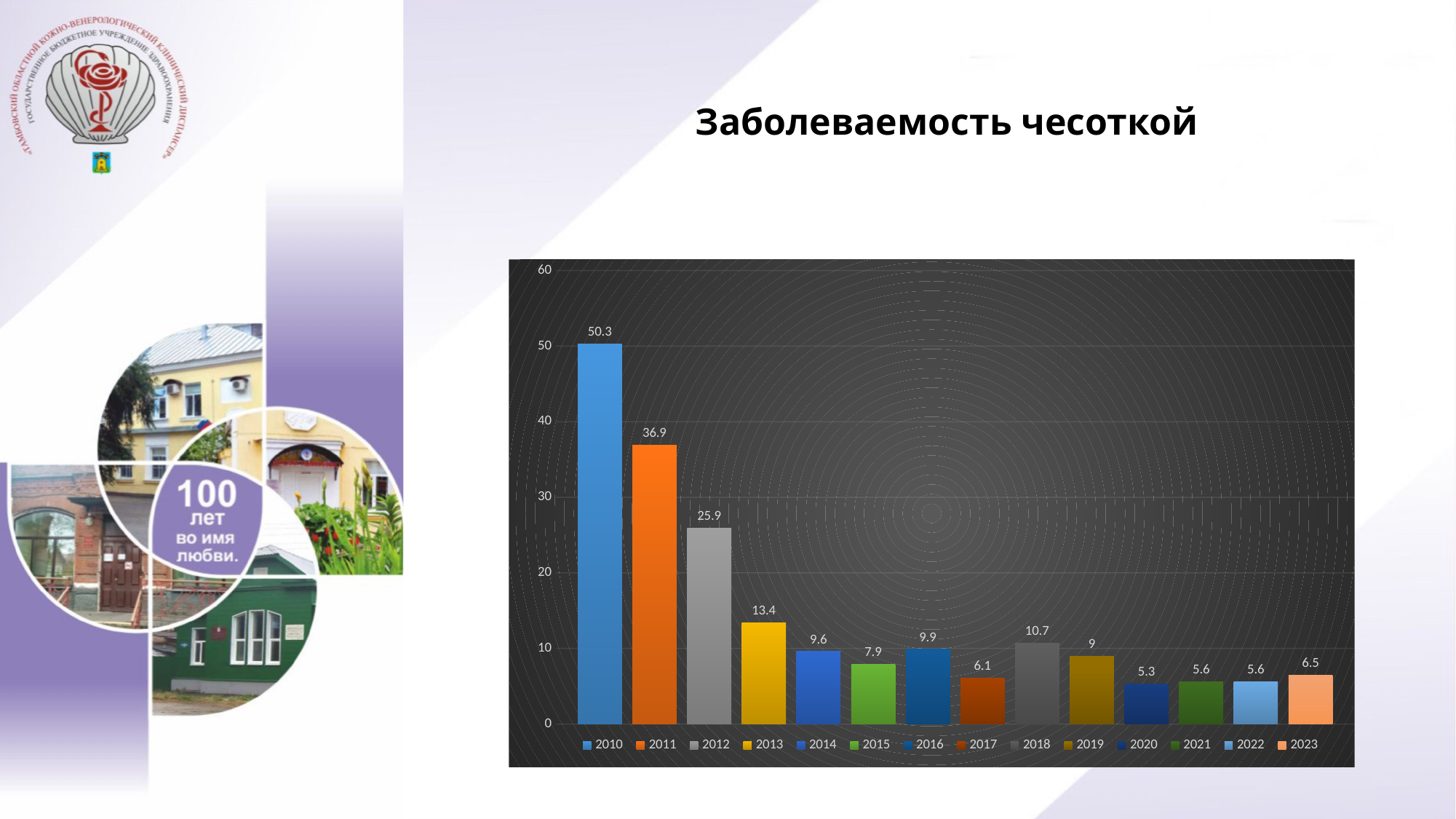
Which is larger, the value for 2016 or the value for 2017? 2016 What is the value shown for 2018? 10.7 How many years are plotted in the chart? 14 What is the difference between the values for 2013 and 2014? 3.8 What is the value shown for 2010? 50.3 Which year has the highest value? 2010 What is the value shown for 2023? 6.5 What kind of chart is shown on the slide? Bar chart What is the difference between the values for 2010 and 2011? 13.4 Is the value for 2012 greater or less than 20? greater Which year has the lowest value? 2020 What is the title of the chart on the slide? Заболеваемость чесоткой